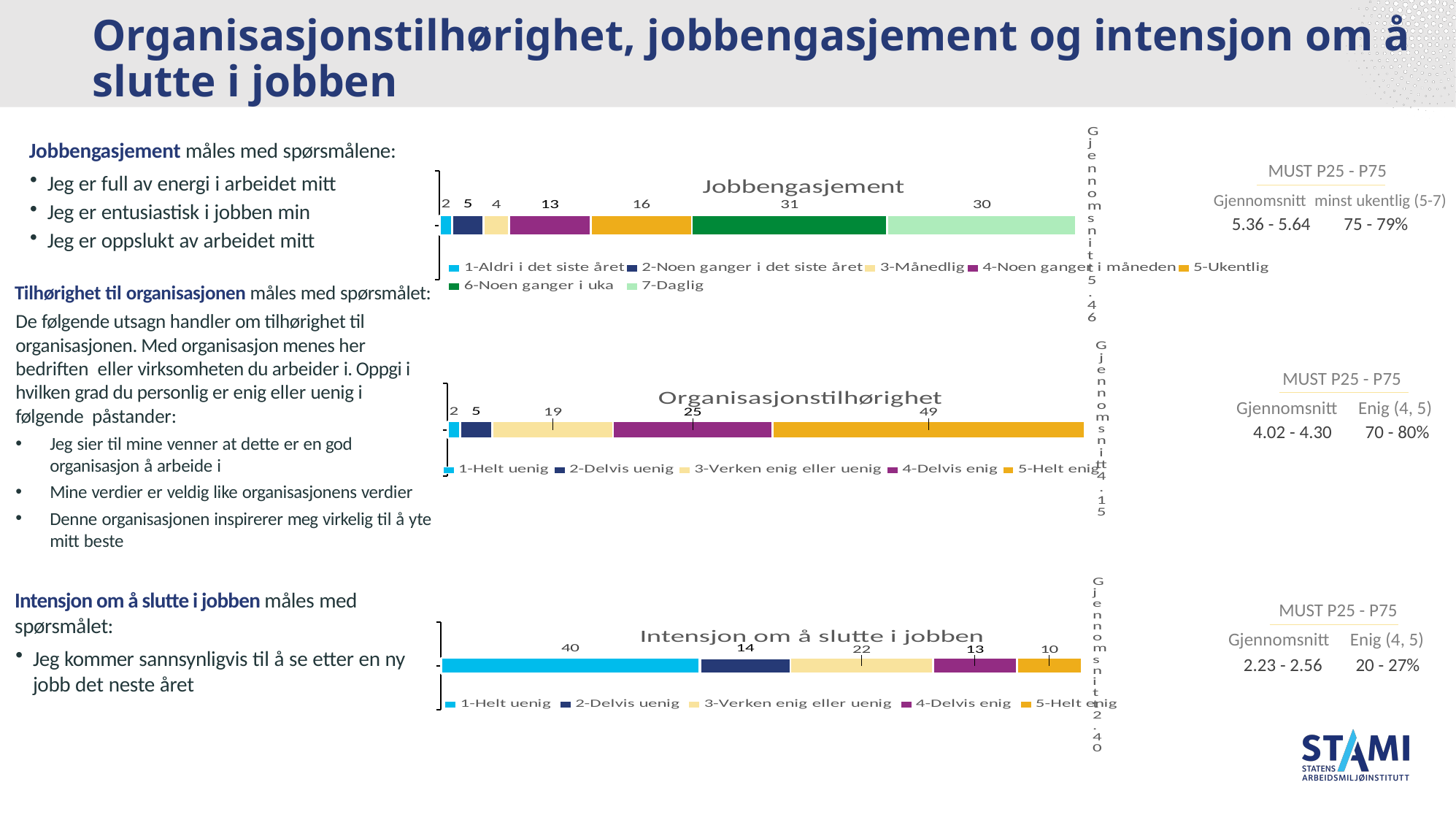
In the Intensjon om å slutte i jobben chart, what is the value for 1-Helt uenig? 40 In the Intensjon om å slutte i jobben chart, how many series does the legend list? 5 In the Jobbengasjement chart, what is the value for 7-Daglig? 30 In the Jobbengasjement chart, how many series does the legend list? 7 In the Organisasjonstilhørighet chart, which series has the highest value? 5-Helt enig In the Intensjon om å slutte i jobben chart, which is larger, 3-Verken enig eller uenig or 2-Delvis uenig? 3-Verken enig eller uenig In the Intensjon om å slutte i jobben chart, what is the total of the stacked bar? 99 In the Jobbengasjement chart, which series has the lowest value? 1-Aldri i det siste året In the Jobbengasjement chart, what is the value for 6-Noen ganger i uka? 31 In the Organisasjonstilhørighet chart, what is the difference between 5-Helt enig and 4-Delvis enig? 24 What type of chart is the Organisasjonstilhørighet chart? Stacked bar chart In the Organisasjonstilhørighet chart, what is the value for 5-Helt enig? 49